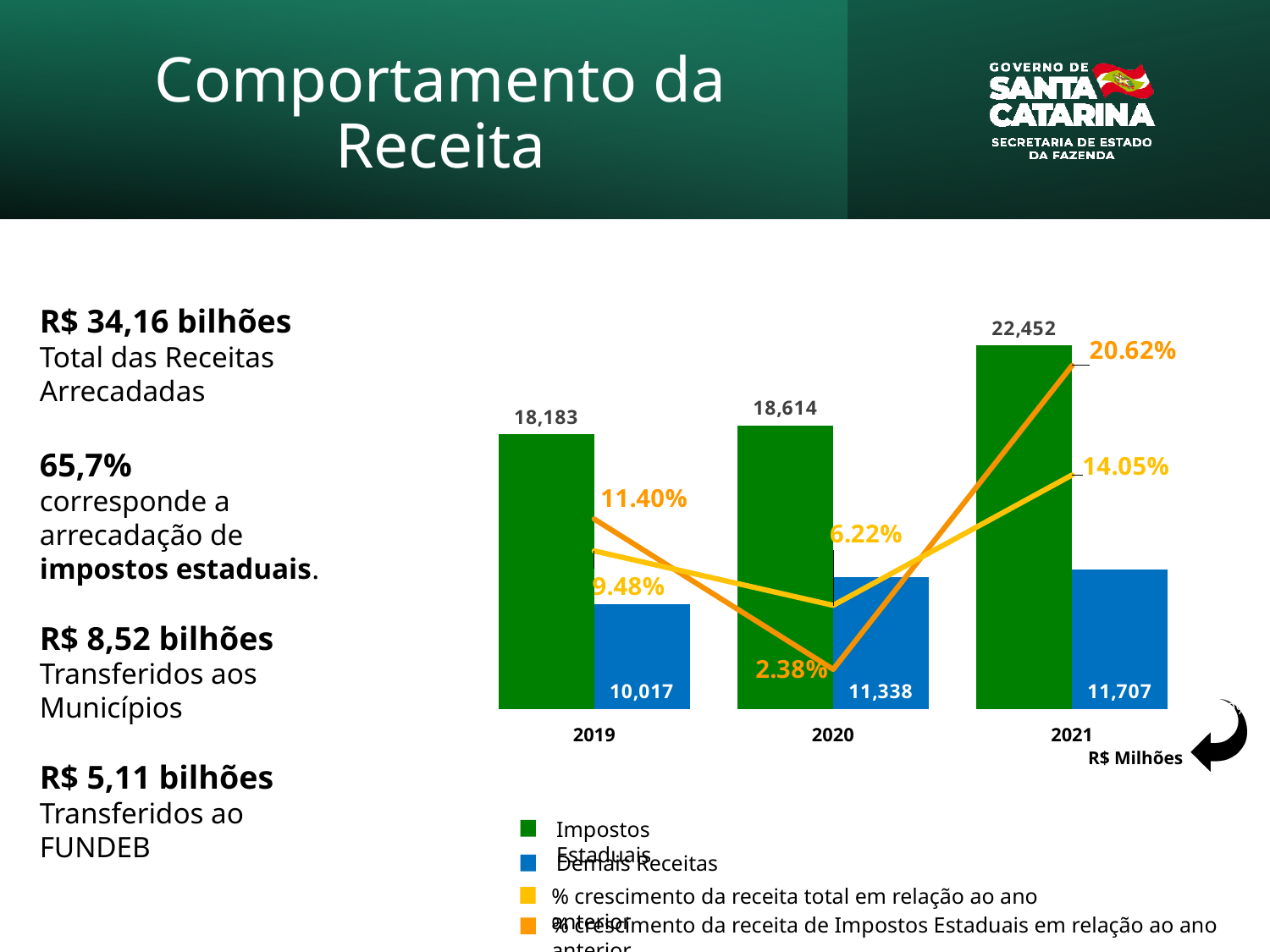
What is the % crescimento da receita de Impostos Estaduais em relação ao ano anterior for 2021? 20.62% Which is larger in 2019: Impostos Estaduais or Demais Receitas? Impostos Estaduais Does Demais Receitas rise or fall from 2019 to 2021? rise In which year is the % crescimento da receita de Impostos Estaduais lowest? 2020 What is the % crescimento da receita total em relação ao ano anterior for 2020? 6.22% In which year is Impostos Estaduais highest? 2021 What is the value of Impostos Estaduais for 2021? 22,452 What is the value of Impostos Estaduais for 2020? 18,614 How many years are shown on the x axis? 3 How many series does the legend list? 4 What is the difference between Impostos Estaduais in 2021 and 2020? 3,838 What is the value of Demais Receitas for 2019? 10,017